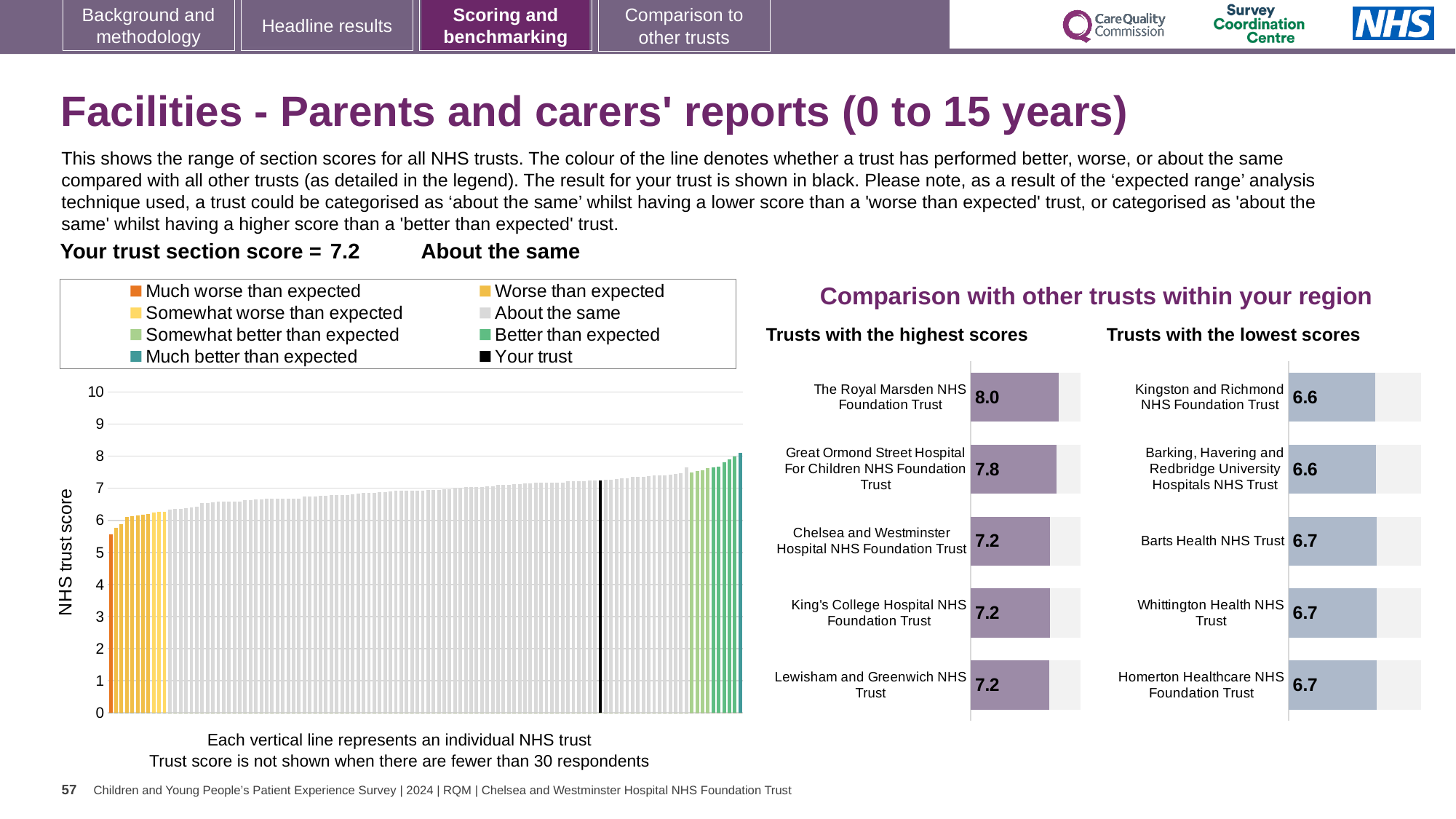
In the 'Trusts with the lowest scores' chart, what is the score for Homerton Healthcare NHS Foundation Trust? 6.7 In the 'Trusts with the highest scores' chart, what is the score for Great Ormond Street Hospital For Children NHS Foundation Trust? 7.8 How many trusts are shown in the 'Trusts with the highest scores' chart? 5 How many entries does the legend above the large chart on the left list? 8 In the 'Trusts with the highest scores' chart, what is the difference between the scores of The Royal Marsden NHS Foundation Trust and Great Ormond Street Hospital For Children NHS Foundation Trust? 0.2 In the 'Trusts with the highest scores' chart, what is the score for The Royal Marsden NHS Foundation Trust? 8.0 In the large chart on the left, do the trust scores rise or fall from left to right? Rise In the 'Trusts with the highest scores' chart, which trust has the highest score? The Royal Marsden NHS Foundation Trust In the 'Trusts with the lowest scores' chart, what is the difference between the scores of Whittington Health NHS Trust and Barking, Havering and Redbridge University Hospitals NHS Trust? 0.1 What kind of chart is the large chart on the left showing NHS trust scores? Bar chart In the 'Trusts with the lowest scores' chart, what is the score for Kingston and Richmond NHS Foundation Trust? 6.6 In the 'Trusts with the lowest scores' chart, which is larger: the score for Barts Health NHS Trust or the score for Kingston and Richmond NHS Foundation Trust? Barts Health NHS Trust